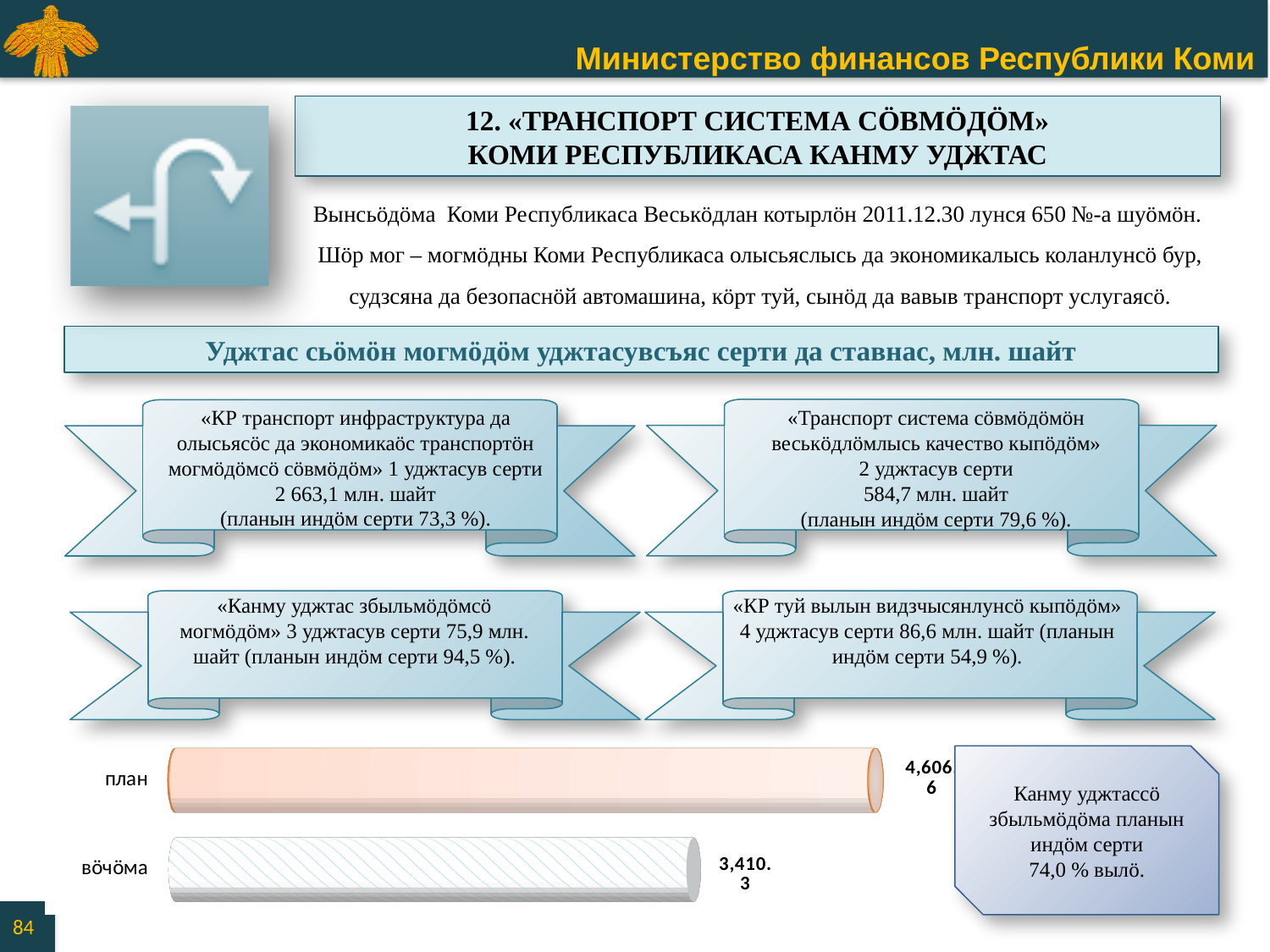
Which category has the higher value in the bar chart, план or вöчöма? план How many bars are shown in the chart at the bottom of the slide? 2 What is the difference between the план and вöчöма values in the bar chart? 1,196.3 Which category has the lowest value in the bar chart at the bottom of the slide? вöчöма What is the value of the вöчöма bar in the bar chart at the bottom of the slide? 3,410.3 What type of chart is shown at the bottom of the slide? bar chart Which bar in the chart is drawn in an orange/peach colour? план What is the value of the план bar in the bar chart at the bottom of the slide? 4,606.6 Which bar in the chart is drawn with a white hatched pattern? вöчöма Is the value for план larger or smaller than the value for вöчöма in the bar chart? larger